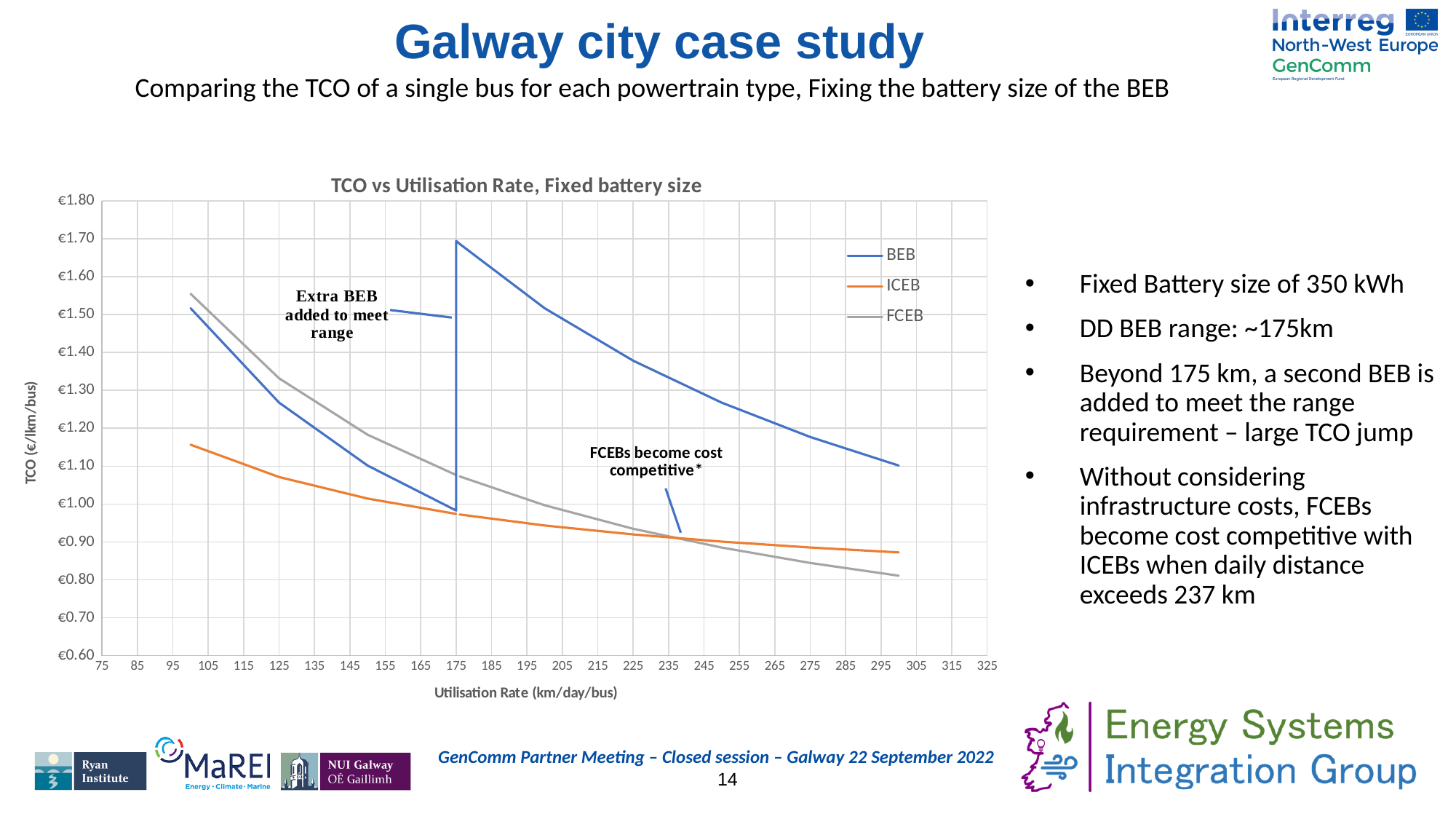
Is the BEB value just after the jump at a utilisation rate of 175 km/day/bus greater or less than €1.60? greater What is the title of the chart? TCO vs Utilisation Rate, Fixed battery size Does the ICEB line rise or fall as the utilisation rate increases? fall How many series does the chart legend list? 3 Is the BEB value at a utilisation rate of 250 km/day/bus greater or less than €1.20? greater What kind of chart is shown on the slide? line chart At a utilisation rate of 300 km/day/bus, which series has the lowest TCO? FCEB At a utilisation rate of 300 km/day/bus, which series has the highest TCO? BEB Is the ICEB value at a utilisation rate of 100 km/day/bus greater or less than €1.10? greater What are the three series named in the chart legend? BEB, ICEB, FCEB At a utilisation rate of 200 km/day/bus, which is larger, the BEB value or the ICEB value? BEB